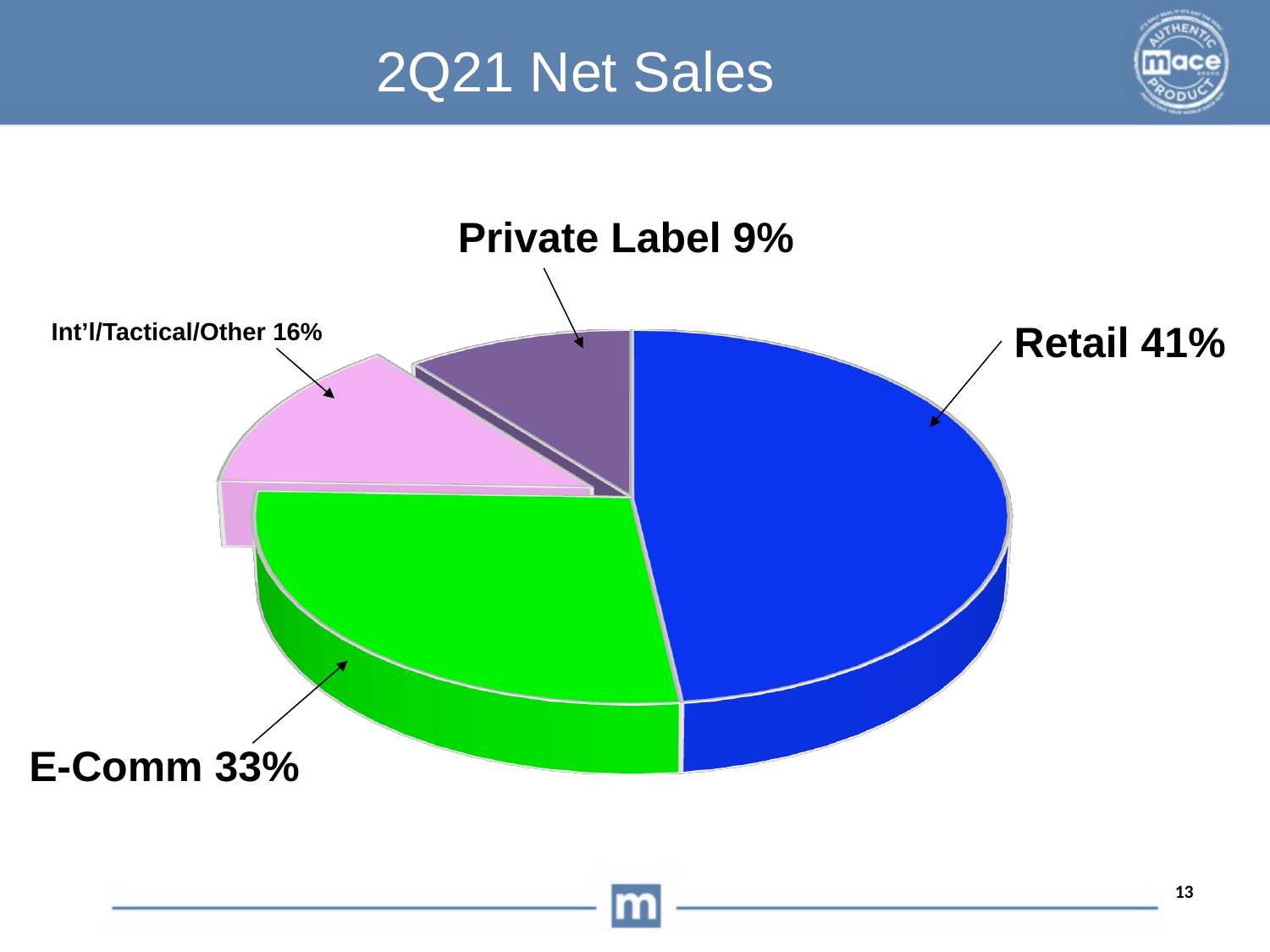
What share of 2Q21 net sales does Retail account for? 41% Which segment has the smallest share of 2Q21 net sales? Private Label Which segment has the largest share of 2Q21 net sales? Retail What is the title of the slide containing the chart? 2Q21 Net Sales How many segments are shown in the pie chart? 4 What kind of chart is shown on the slide? Pie chart How many percentage points larger is Retail's share than E-Comm's share? 8 How many percentage points larger is Int'l/Tactical/Other's share than Private Label's share? 7 What share of 2Q21 net sales does Private Label account for? 9% What share of 2Q21 net sales does E-Comm account for? 33% Which has a larger share of 2Q21 net sales, E-Comm or Int'l/Tactical/Other? E-Comm What share of 2Q21 net sales does Int'l/Tactical/Other account for? 16%